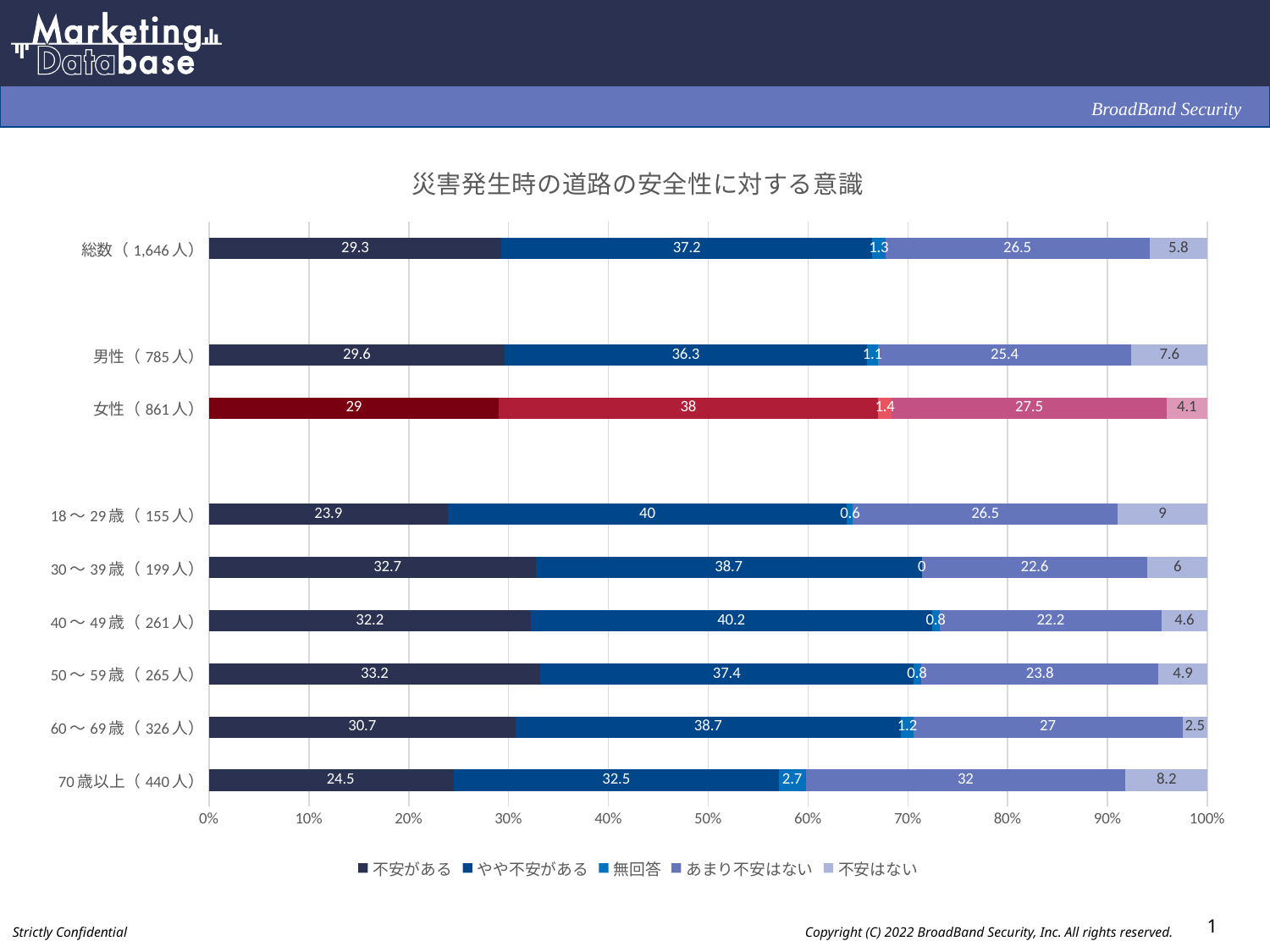
Which category has the lowest value for 不安がある? 18～29歳 (155人) Which category has the highest value for 不安がある? 50～59歳 (265人) What is the value of 不安がある for 総数 (1,646人)? 29.3 Which is larger, the やや不安がある value for 男性 (785人) or for 女性 (861人)? 女性 (861人) What is the total of the stacked bar for 総数 (1,646人)? 100.1 What is the value of 不安はない for 70歳以上 (440人)? 8.2 How many categories are shown on the chart? 9 How many series does the legend list? 5 What kind of chart is shown on the slide? Stacked bar chart What is the difference between the 不安はない values for 男性 (785人) and 女性 (861人)? 3.5 What is the title of the chart? 災害発生時の道路の安全性に対する意識 What is the value of 無回答 for 30～39歳 (199人)? 0